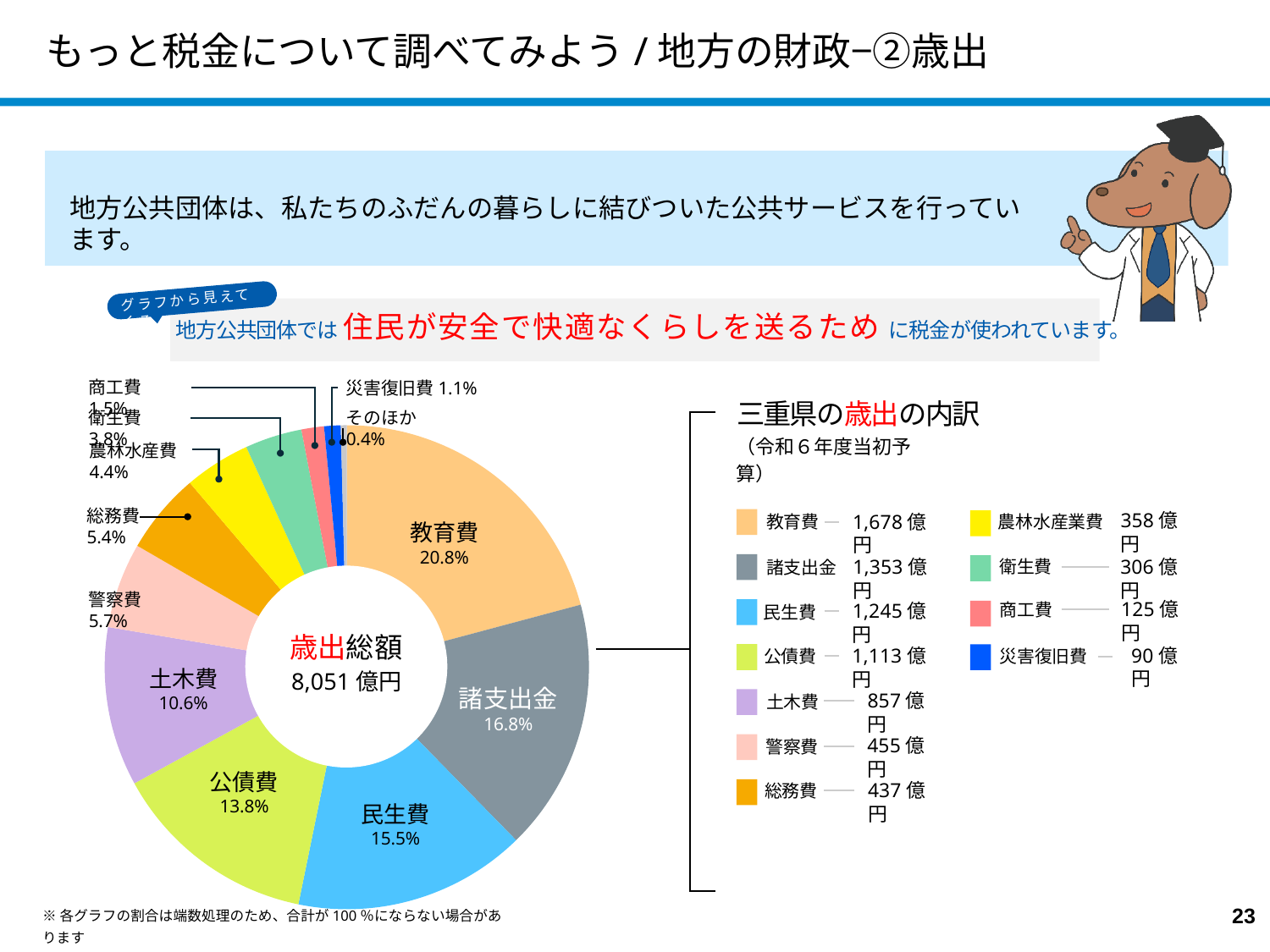
What kind of chart is shown on the slide? Pie chart (donut) Which category has the largest share of the pie? 教育費 What is the difference in percentage points between 民生費 and 公債費? 1.7 Which is larger, the share for 土木費 or the share for 警察費? 土木費 What is the total expenditure (歳出総額) shown in the centre of the chart? 8,051 億円 How many slices are labelled on the pie chart? 12 Which labelled category has the smallest share of the pie? そのほか What is the difference in amount between 教育費 and 民生費 according to the legend? 433 億円 What share of the pie does 教育費 represent? 20.8% What is the title of the chart shown on the slide? 三重県の歳出の内訳 What share of the pie does 災害復旧費 represent? 1.1% What is the amount shown for 諸支出金 in the legend? 1,353 億円